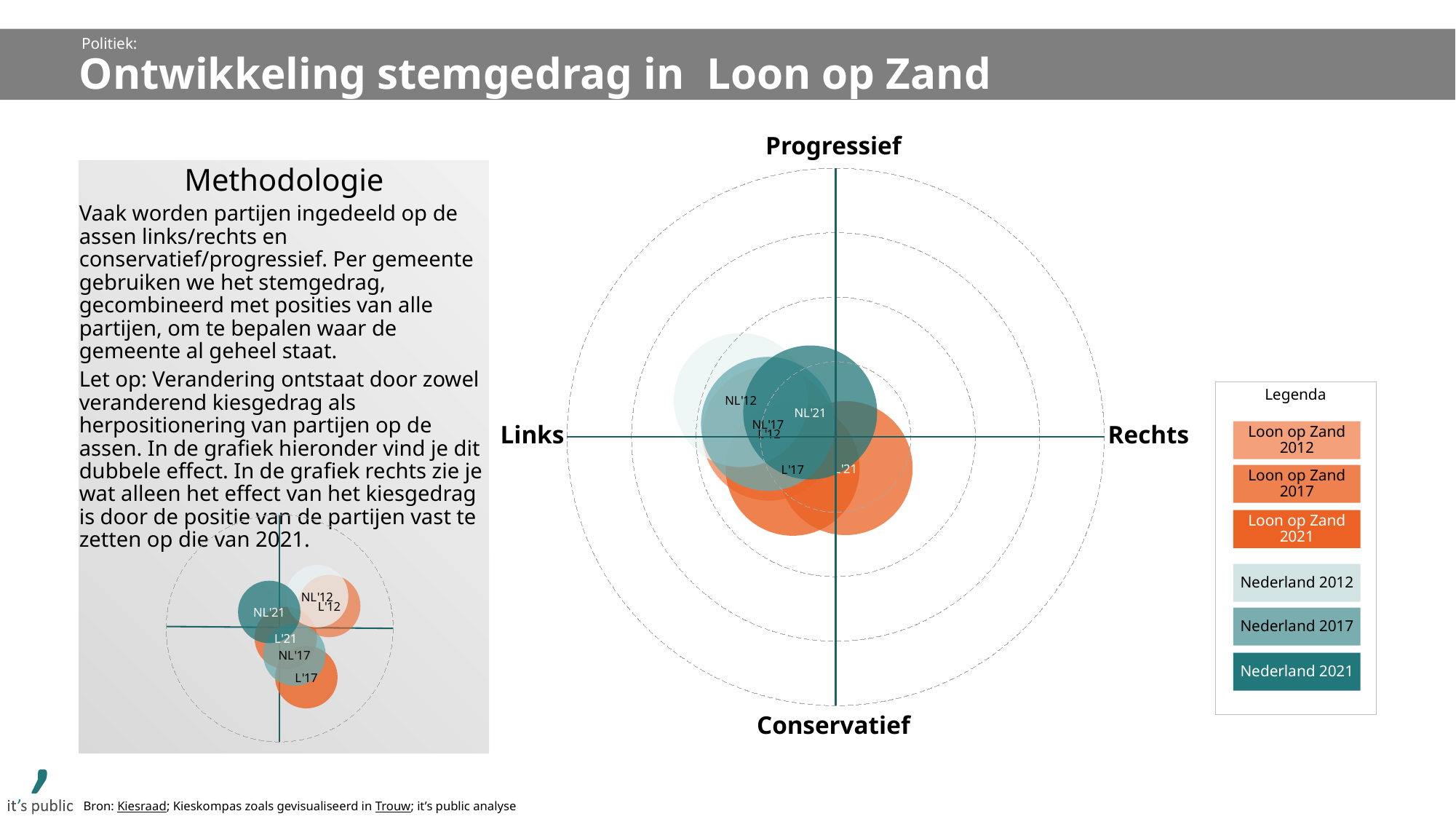
In the large chart, which is further toward Progressief: the Nederland 2021 bubble (NL'21) or the Loon op Zand 2017 bubble (L'17)? NL'21 Which legend entry is shown in the darkest teal colour? Nederland 2021 In the large chart, how many labelled bubbles are plotted? 6 In the small chart at the lower left, is the Nederland 2021 bubble (NL'21) to the left or to the right of the vertical axis? Left In the small chart at the lower left, is the Loon op Zand 2017 bubble (L'17) above or below the horizontal axis? Below How many entries does the legend (Legenda) list? 6 In the large chart, what is the label at the right end of the horizontal axis? Rechts In the large chart, what is the label at the top of the vertical axis? Progressief What kind of chart is the large chart on the right side of the slide? Bubble chart